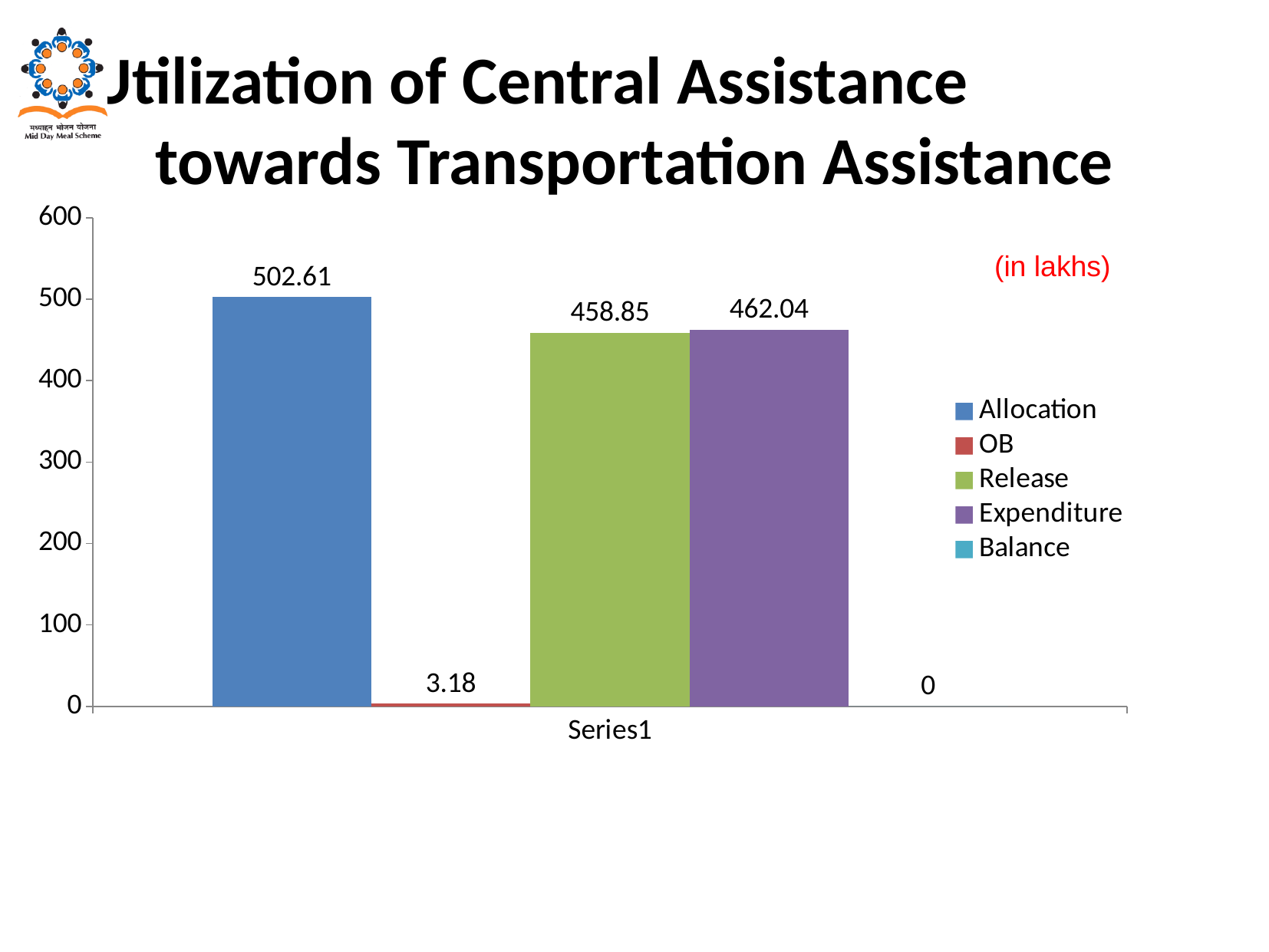
What kind of chart is shown on the slide? Bar chart Which is larger, Expenditure or Release? Expenditure What is the value for OB? 3.18 Which series has the lowest value? Balance How many series does the legend list? 5 What is the value for Expenditure? 462.04 What is the value for Balance? 0 Which series has the highest value? Allocation In what units are the values on the chart expressed? in lakhs What is the difference between Allocation and Release? 43.76 What is the value for Release? 458.85 What is the value for Allocation? 502.61